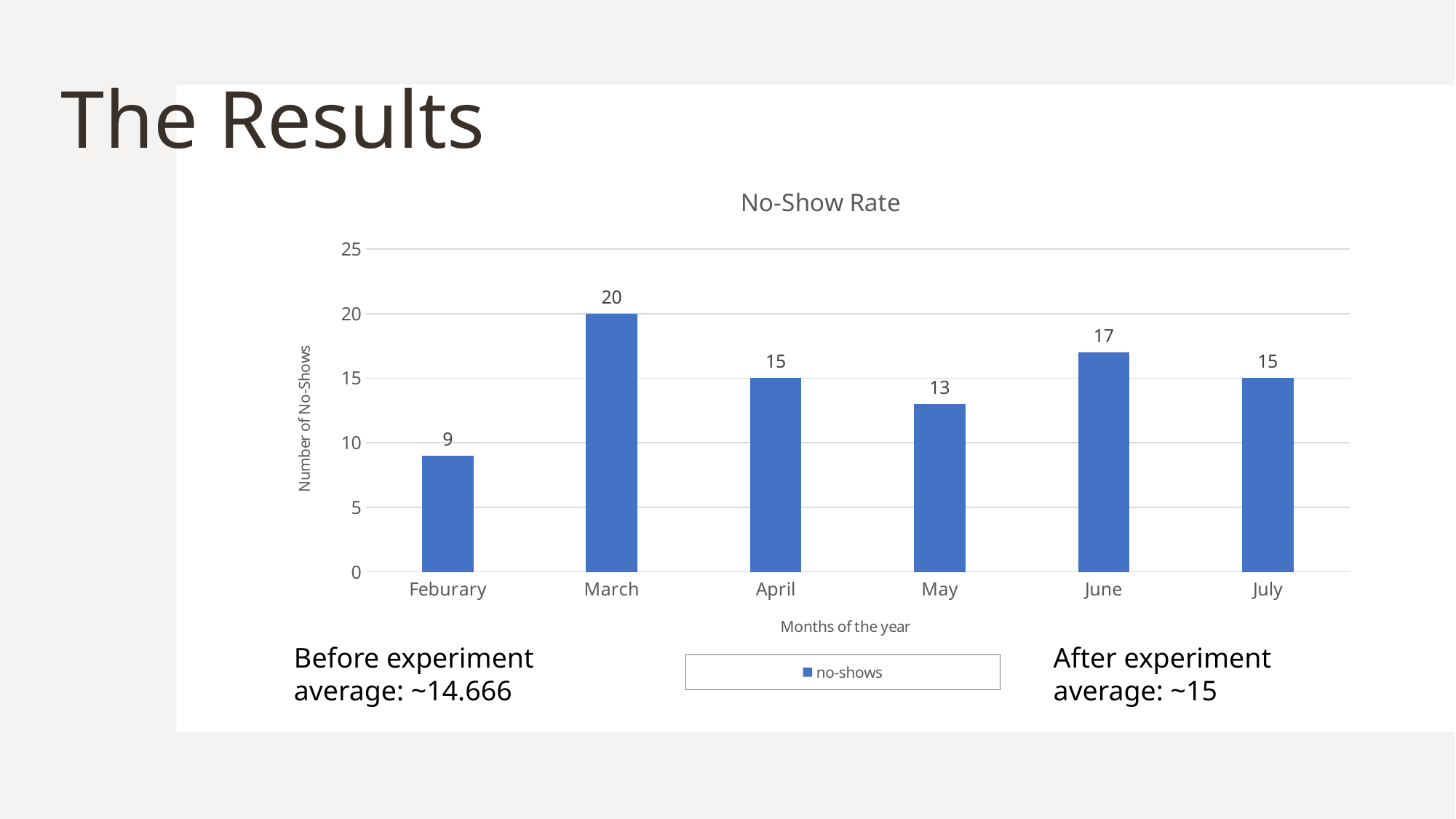
What is the title of the chart? No-Show Rate Which month has the highest number of no-shows? March Is the value for May greater or less than 10? greater Which month has the lowest number of no-shows? Feburary What is the number of no-shows for June? 17 Which month has more no-shows, June or July? June What kind of chart is shown on the slide? bar chart What is the number of no-shows for March? 20 What is the number of no-shows for Feburary? 9 What is the difference in no-shows between March and May? 7 How many series does the legend list? 1 How many months are shown on the x axis? 6